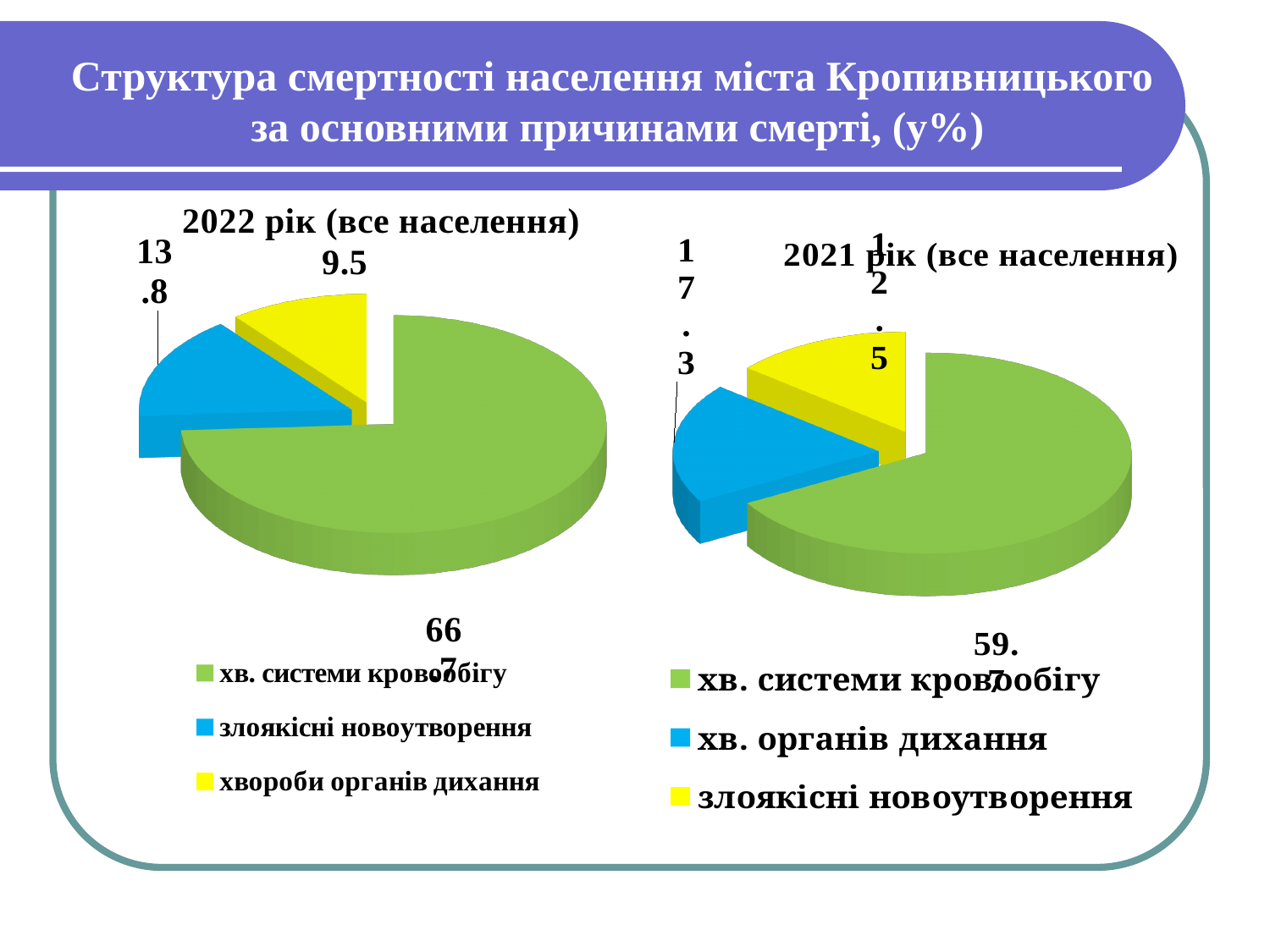
What is the difference between the value for хв. системи кровообігу in the 2022 chart and in the 2021 chart? 7.0 How many slices does the 2021 рік (все населення) pie chart have? 3 Which is larger: злоякісні новоутворення in the 2022 chart or злоякісні новоутворення in the 2021 chart? 2022 chart In the 2022 рік (все населення) chart, which category has the largest slice? хв. системи кровообігу In the 2022 рік (все населення) chart, what is the value for злоякісні новоутворення? 13.8 In the 2021 рік (все населення) chart, what is the value for хв. системи кровообігу? 59.7 What type of chart is the 2022 рік (все населення) chart? pie chart In the 2021 рік (все населення) chart, which category has the smallest slice? злоякісні новоутворення In the 2021 рік (все населення) chart, what is the value for хв. органів дихання? 17.3 In the 2022 рік (все населення) chart, what is the value for хв. системи кровообігу? 66.7 In the 2021 рік (все населення) chart, what is the value for злоякісні новоутворення? 12.5 In the 2022 рік (все населення) chart, what is the value for хвороби органів дихання? 9.5